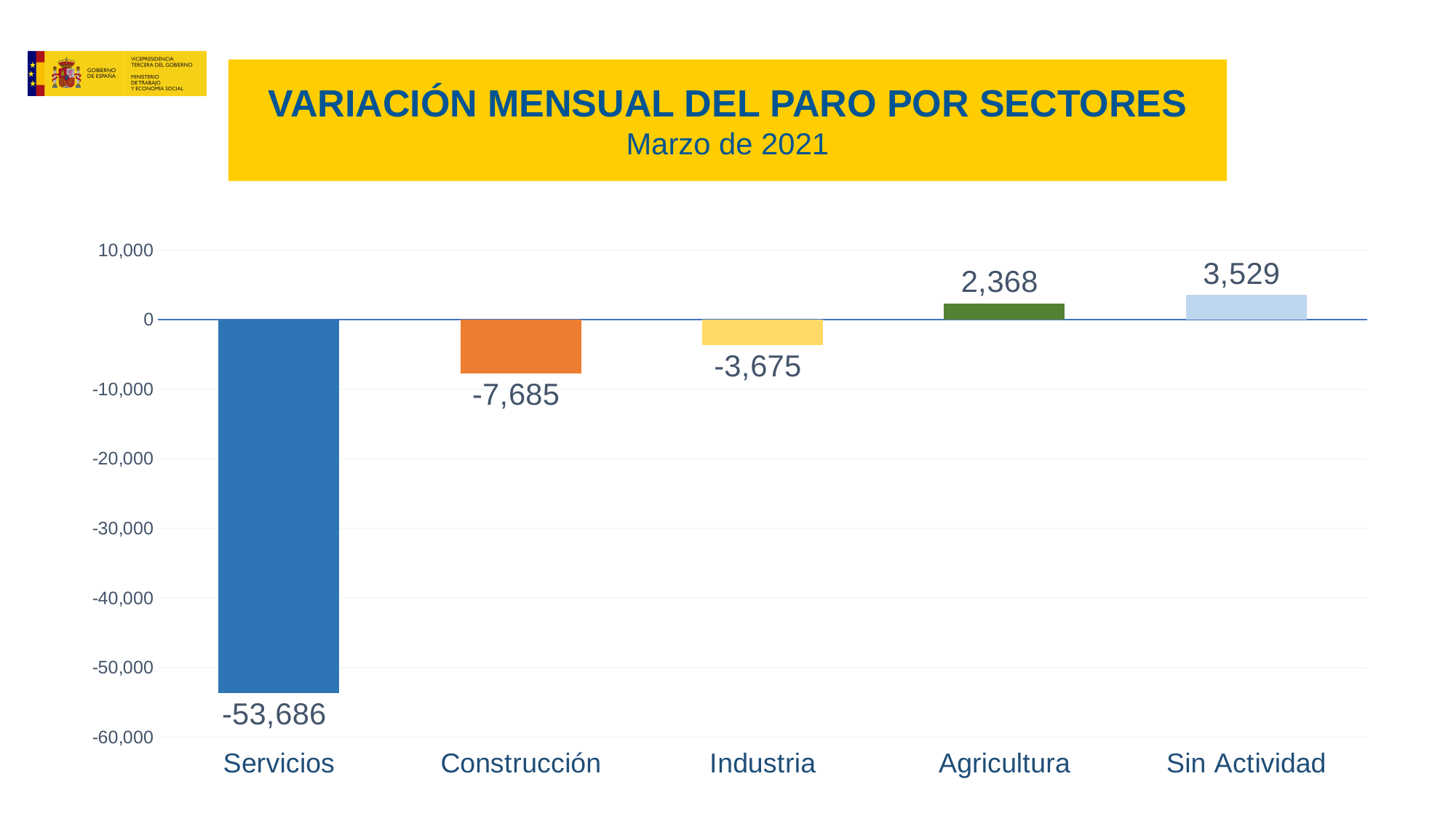
What is the value for Agricultura? 2,368 How many sectors are shown on the chart? 5 What is the value for Sin Actividad? 3,529 What is the value for Construcción? -7,685 What is the difference between the values for Sin Actividad and Agricultura? 1,161 What is the value for Servicios? -53,686 Which sector has the highest value? Sin Actividad Which sector has the lowest value? Servicios Which is larger, the value for Construcción or the value for Industria? Industria What month and year does the chart title refer to? Marzo de 2021 What is the value for Industria? -3,675 What kind of chart is shown on the slide? Bar chart